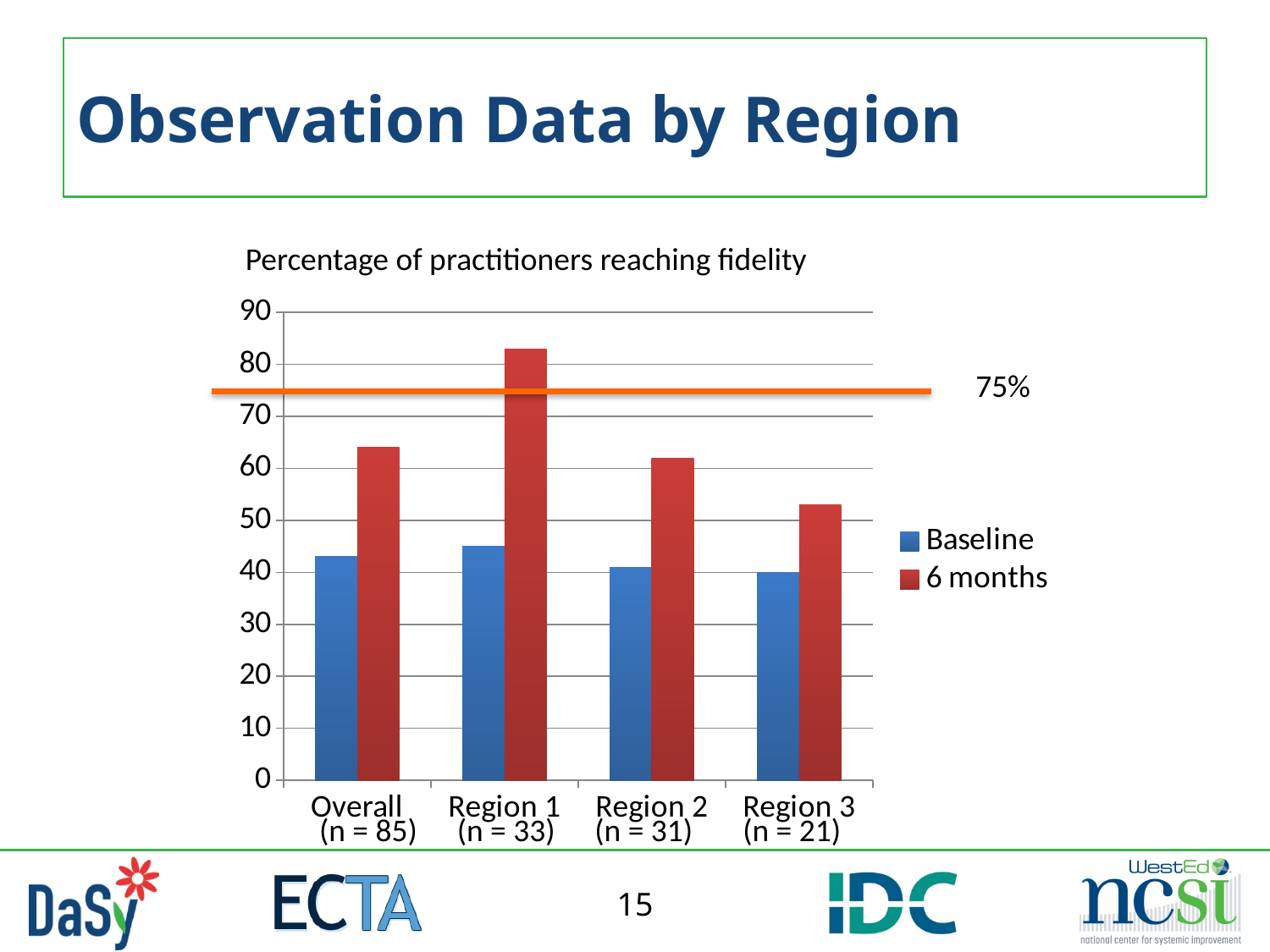
How many series does the legend list? 2 Is the Baseline value for Region 2 greater or less than 50? less Is the 6 months value for Overall greater or less than 60? greater How many categories are shown on the x axis? 4 Is the 6 months value for Region 3 greater or less than 60? less What kind of chart is shown on the slide? bar chart Which category has the highest 6 months value? Region 1 (n = 33) What is the title of the chart? Percentage of practitioners reaching fidelity What value does the orange horizontal line on the chart mark? 75% Which is larger for Region 2, the Baseline value or the 6 months value? 6 months Which category has the lowest 6 months value? Region 3 (n = 21)